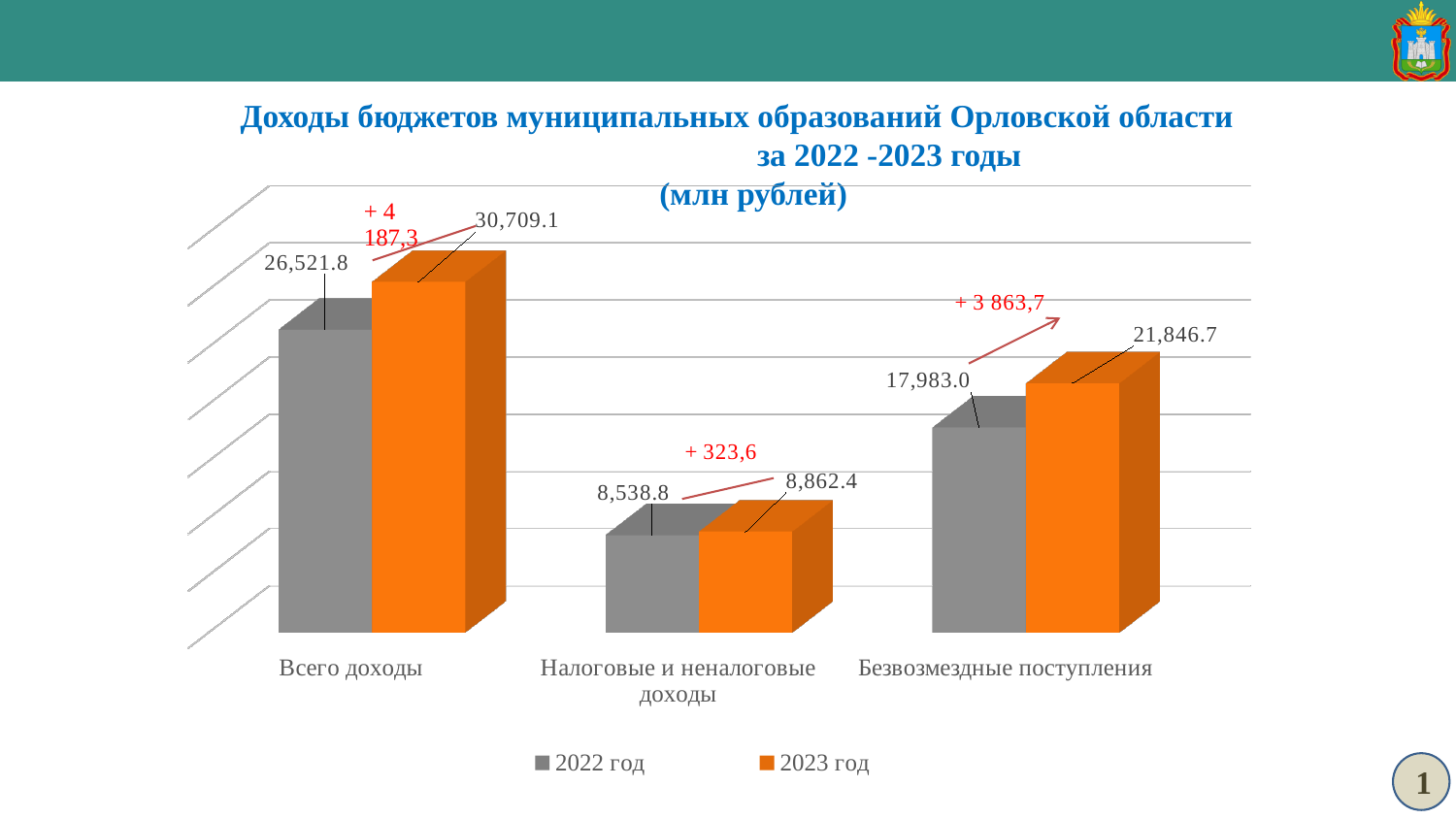
How many series does the legend list? 2 How many categories are shown on the x axis? 3 Which category has the lowest value in 2022 год? Налоговые и неналоговые доходы Which is larger for Налоговые и неналоговые доходы: the 2022 год value or the 2023 год value? 2023 год What is the value for Всего доходы in 2022 год? 26,521.8 What kind of chart is shown on the slide? Bar chart What is the difference between the 2023 год and 2022 год values for Всего доходы? 4,187.3 What is the value for Налоговые и неналоговые доходы in 2023 год? 8,862.4 What is the difference between the 2023 год and 2022 год values for Безвозмездные поступления? 3,863.7 What is the value for Всего доходы in 2023 год? 30,709.1 Which category has the highest value in 2023 год? Всего доходы What is the value for Безвозмездные поступления in 2022 год? 17,983.0